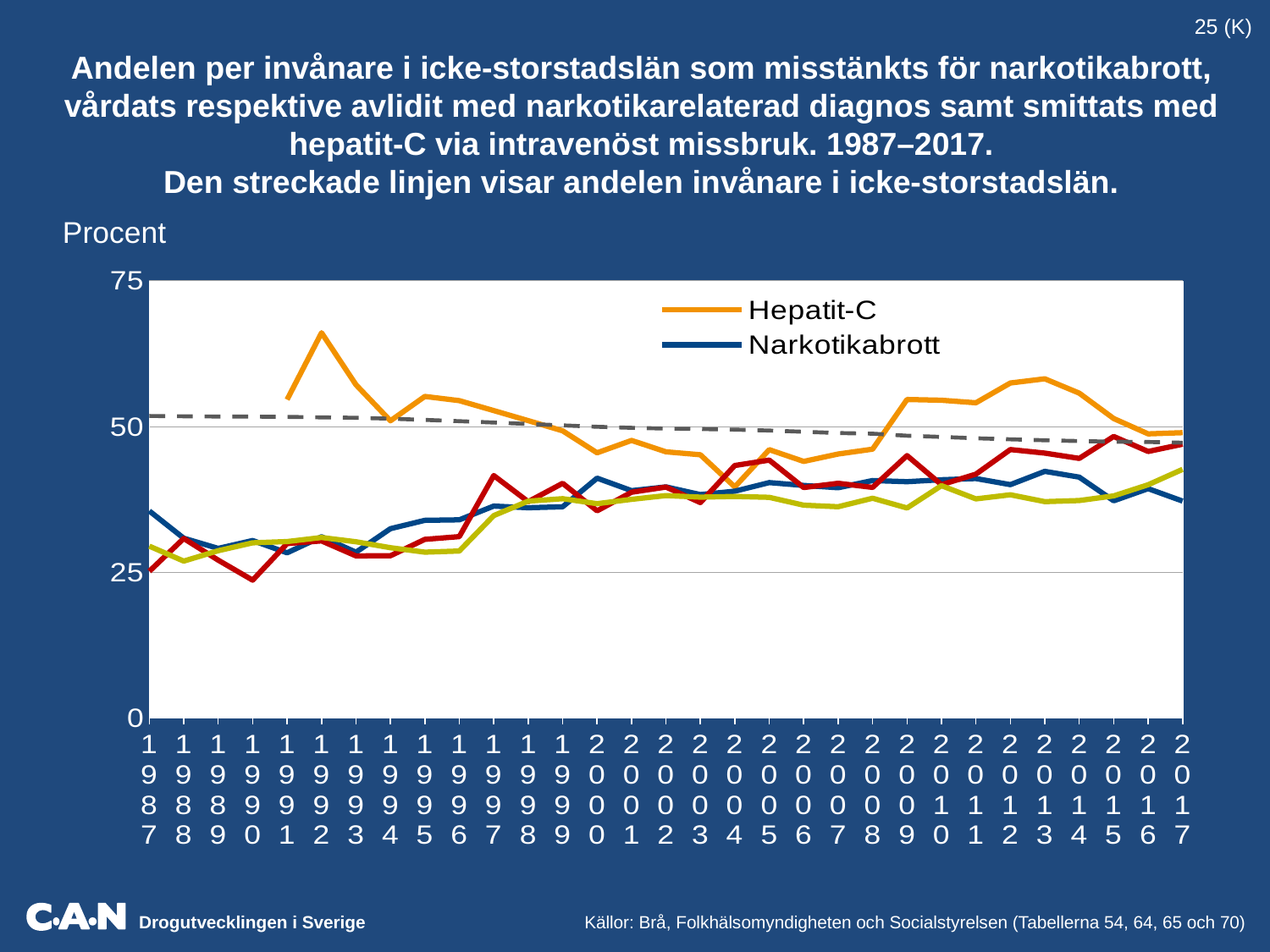
How many series does the legend list? 2 Is the value for Narkotikabrott in 1990 greater or less than 25? greater In 1992, which series has the larger value, Hepatit-C or Narkotikabrott? Hepatit-C Is the value for Hepatit-C in 1992 greater or less than 50? greater Is the value for Narkotikabrott in 1987 greater or less than 50? less How many years are shown along the x axis? 31 What kind of chart is shown on the slide? line chart What label is shown above the y axis of the chart? Procent Does the Hepatit-C line rise or fall from 2013 to 2016? fall In which year does the Hepatit-C line reach its highest value? 1992